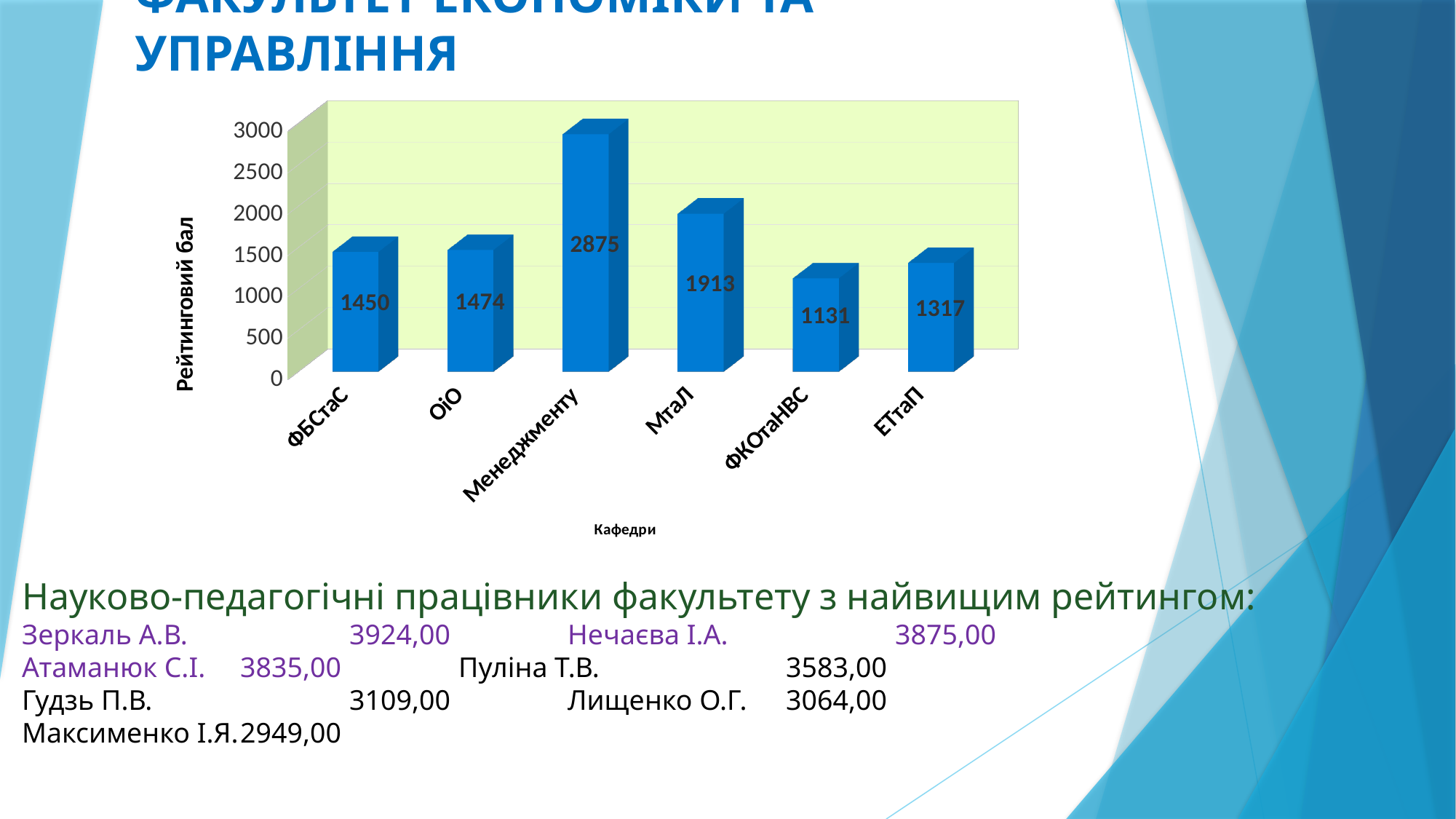
What is the label of the vertical axis of the chart? Рейтинговий бал How many departments are shown in the chart? 6 What is the rating score for the ФКОтаНВС department? 1131 Which department has the lowest rating score? ФКОтаНВС What is the difference between the rating scores of Менеджменту and МтаЛ? 962 What is the rating score for the Менеджменту department? 2875 Is the value for МтаЛ greater or less than 1500? greater What kind of chart is shown on the slide? bar chart Which department has the highest rating score? Менеджменту What is the difference between the rating scores of ОіО and ФБСтаС? 24